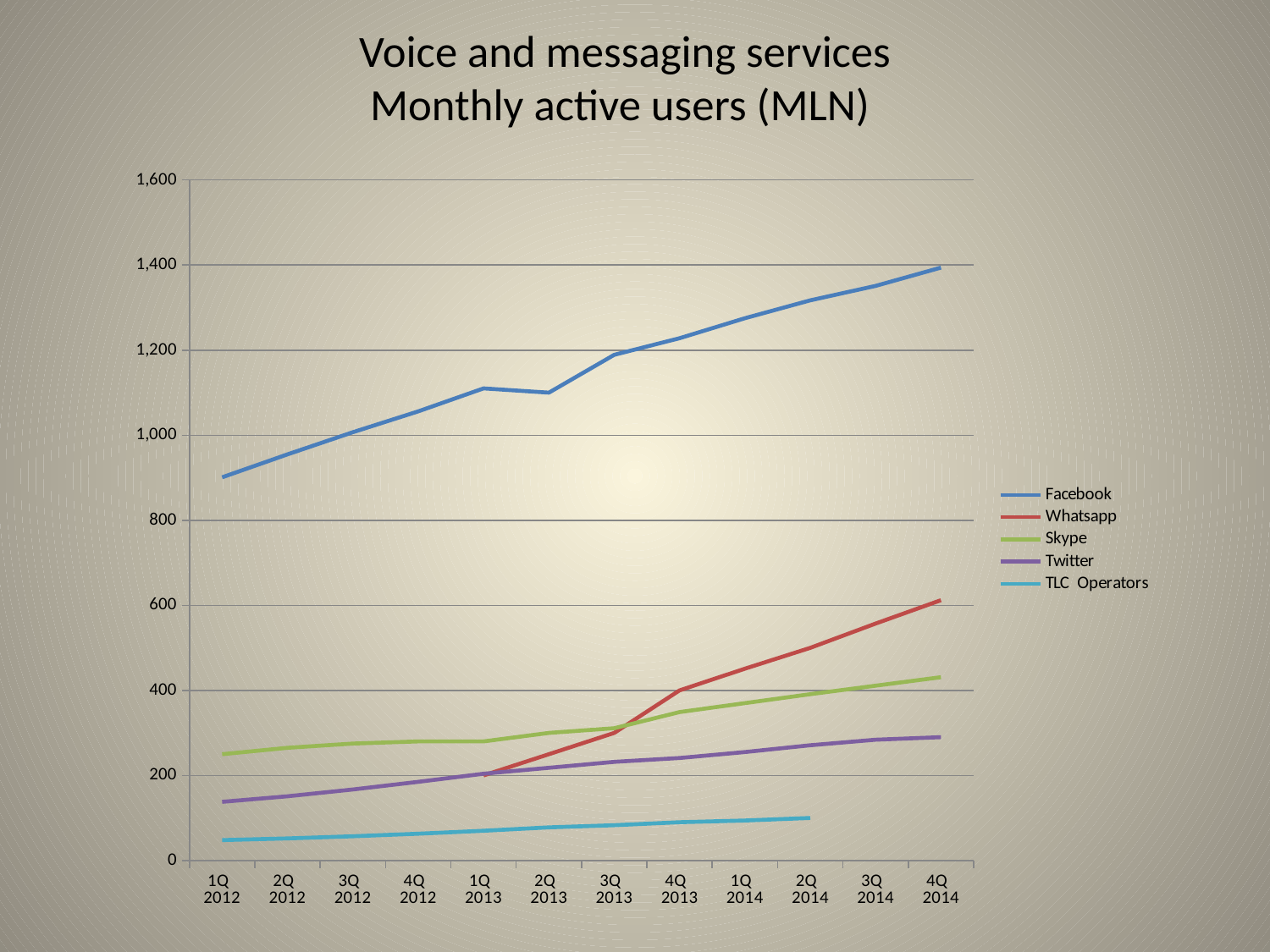
What is the title of the chart? Voice and messaging services Monthly active users (MLN) Is the value for Facebook in 4Q 2014 greater or less than 1,200? greater How many series does the legend list? 5 Which series has the lowest monthly active users in 1Q 2012? TLC Operators In 4Q 2014, which is larger: Whatsapp or Skype? Whatsapp Which series has the highest monthly active users in 4Q 2014? Facebook Is the value for Twitter in 4Q 2014 greater or less than 400? less In 1Q 2012, which is larger: Skype or Twitter? Skype What kind of chart is shown on the slide? Line chart Does the Facebook line rise or fall from 1Q 2012 to 4Q 2014? Rises How many quarters are shown along the x axis? 12 Is the value for Facebook in 1Q 2012 greater or less than 1,000? less